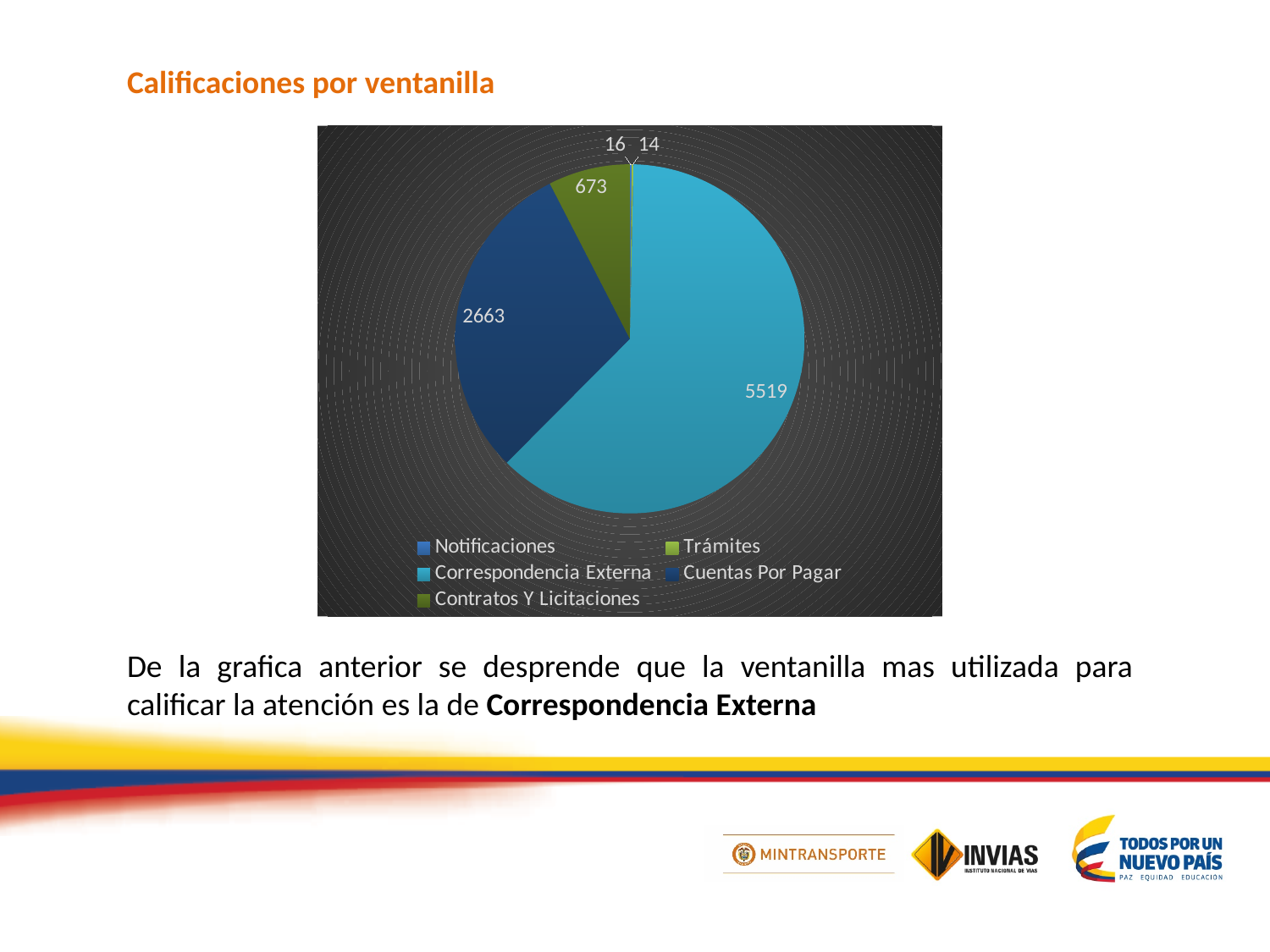
What is the difference between the values for Cuentas Por Pagar and Contratos Y Licitaciones? 1990 What type of chart is shown on the slide? pie chart How many slices does the pie chart have? 5 How many series does the legend list? 5 Which is larger, the value for Cuentas Por Pagar or the value for Contratos Y Licitaciones? Cuentas Por Pagar What is the total of all the values shown on the pie chart? 8885 What is the title of the chart on the slide? Calificaciones por ventanilla What is the value for Cuentas Por Pagar? 2663 What is the value for Contratos Y Licitaciones? 673 What is the difference between the values for Correspondencia Externa and Cuentas Por Pagar? 2856 What is the value for Correspondencia Externa? 5519 Which category has the largest slice of the pie? Correspondencia Externa